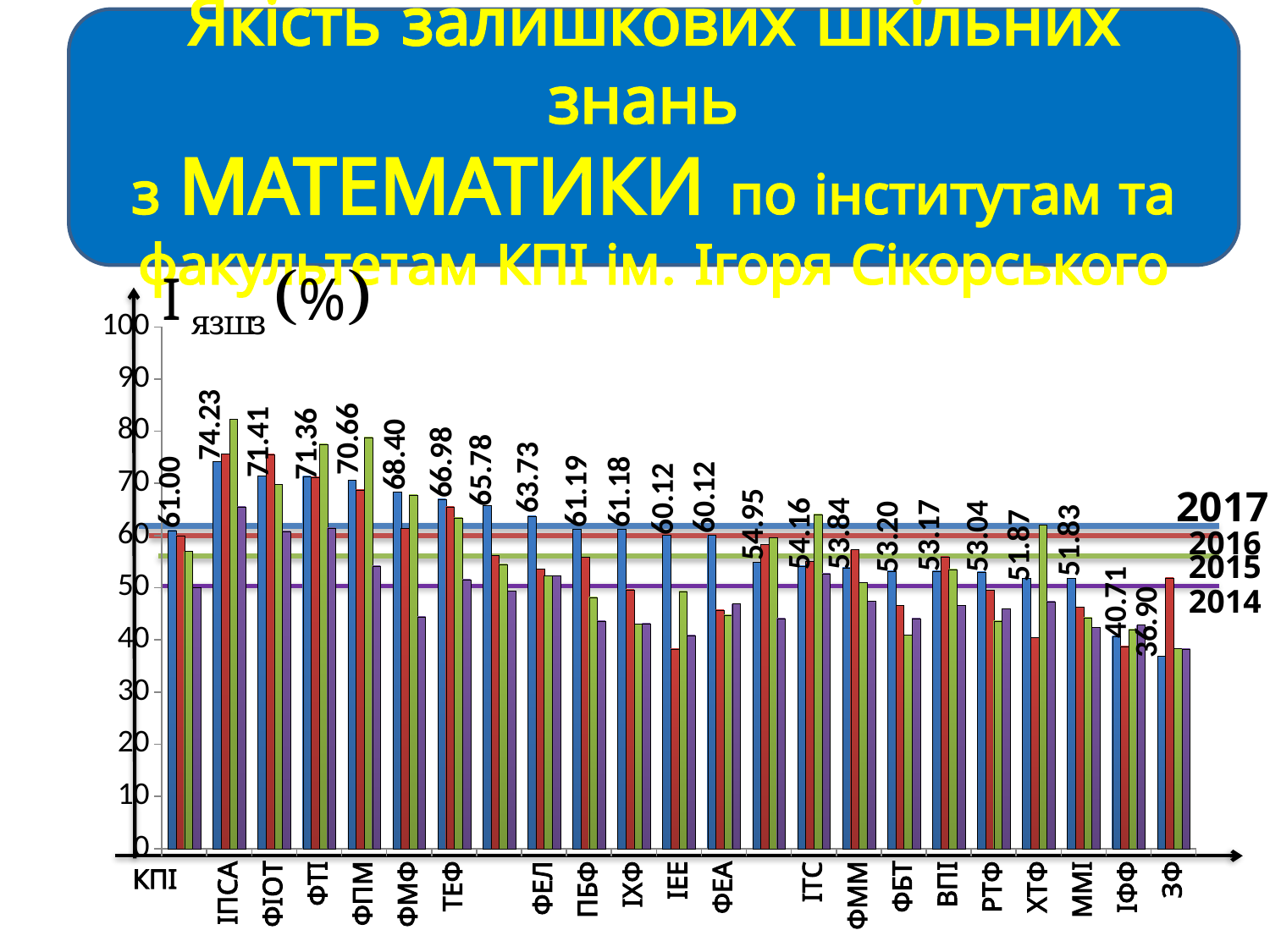
Which has the larger 2017 value, ФМФ or ТЕФ? ФМФ What is the difference between the 2017 values for ФЕЛ and ПБФ? 2.54 How many series (years) does the chart show? 4 Which institute or faculty has the lowest 2017 value? ЗФ What is the 2017 value for ІПСА? 74.23 What is the 2017 value for ІФФ? 40.71 What kind of chart is shown on the slide? bar chart Is the 2016 value for ІЕЕ greater or less than 40? less Which institute or faculty has the highest 2017 value? ІПСА What is the 2017 value for ЗФ? 36.90 What is the difference between the 2017 values for ІПСА and ЗФ? 37.33 Is the 2015 value for ІПСА greater or less than 80? greater